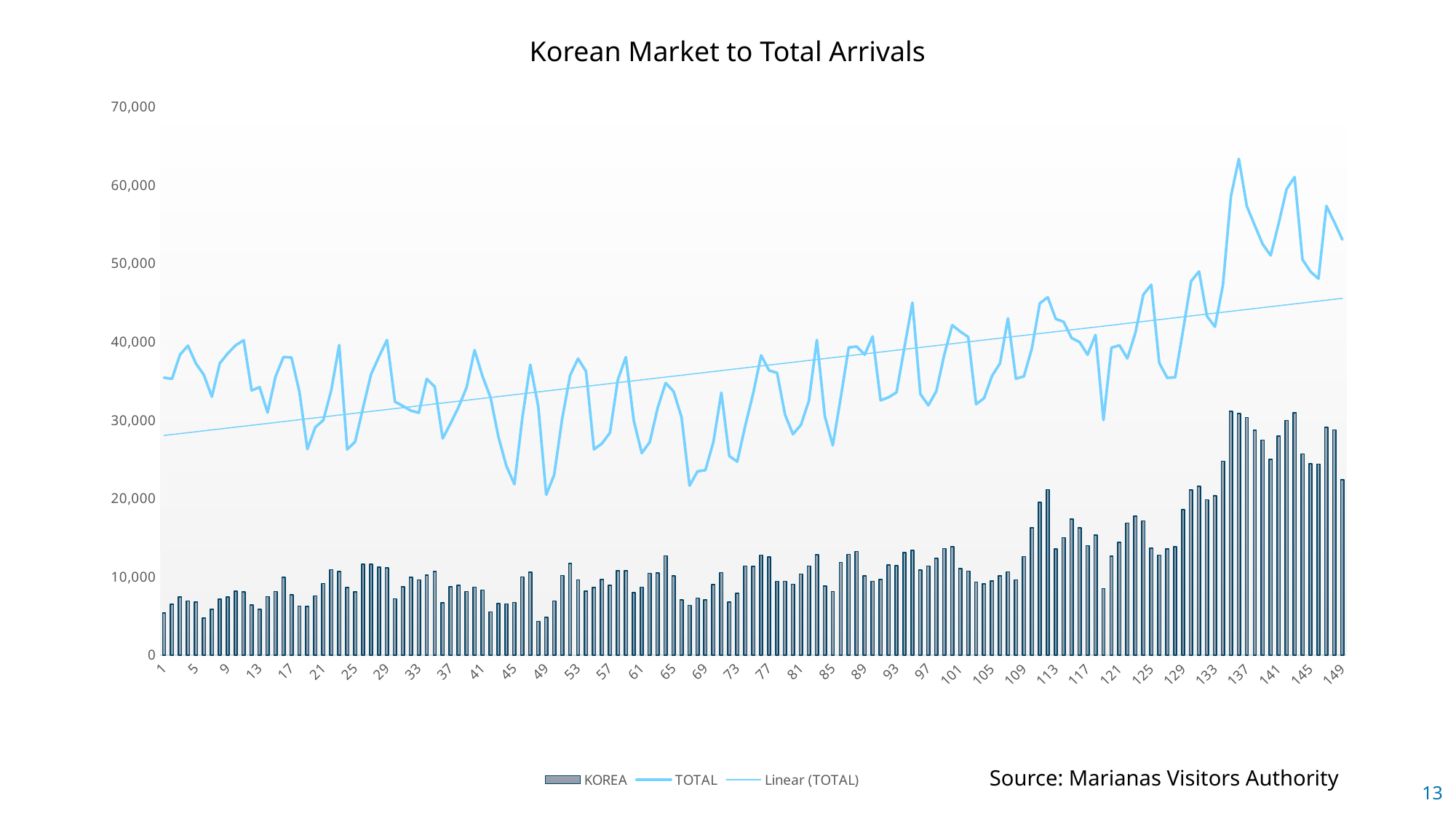
Which series is drawn as bars in the chart? KOREA What is the title of the chart? Korean Market to Total Arrivals Is the TOTAL value at point 49 greater or less than 30,000? less Does the TOTAL series generally rise or fall from point 1 to point 149? rise Is the TOTAL value at point 1 greater or less than 30,000? greater How many entries does the chart legend list? 3 Is the KOREA value at point 1 greater or less than 10,000? less Which is larger for the TOTAL series: the value at point 137 or the value at point 1? point 137 What kind of chart is shown on the slide? Combination bar and line chart Which is larger at point 149: the TOTAL value or the KOREA value? TOTAL